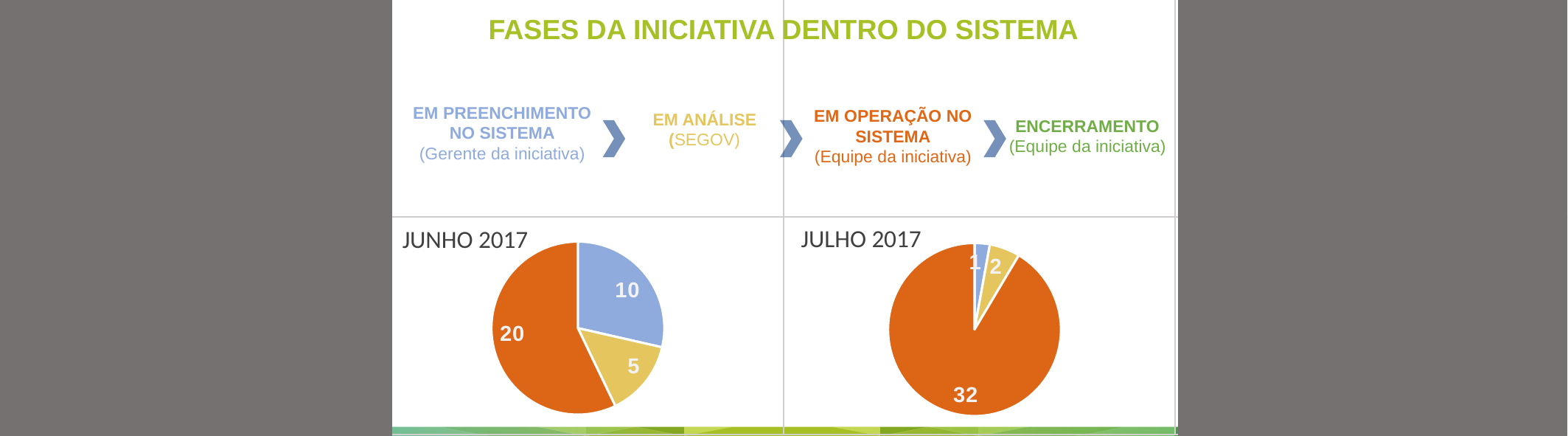
What kind of chart is used for JUNHO 2017? pie chart In the JULHO 2017 pie chart, what is the difference between the orange slice and the yellow slice? 30 Which chart has the larger orange slice value, JUNHO 2017 or JULHO 2017? JULHO 2017 In the JUNHO 2017 pie chart, what is the difference between the orange slice and the blue slice? 10 In the JUNHO 2017 pie chart, what is the value of the orange slice? 20 In the JULHO 2017 pie chart, which slice has the smallest value? the blue slice (1) In the JUNHO 2017 pie chart, what is the value of the yellow slice? 5 How many slices does the JUNHO 2017 pie chart have? 3 In the JUNHO 2017 pie chart, which slice has the largest value? the orange slice (20) In the JULHO 2017 pie chart, what is the value of the blue slice? 1 In the JUNHO 2017 pie chart, what is the value of the blue slice? 10 In the JULHO 2017 pie chart, what is the value of the orange slice? 32